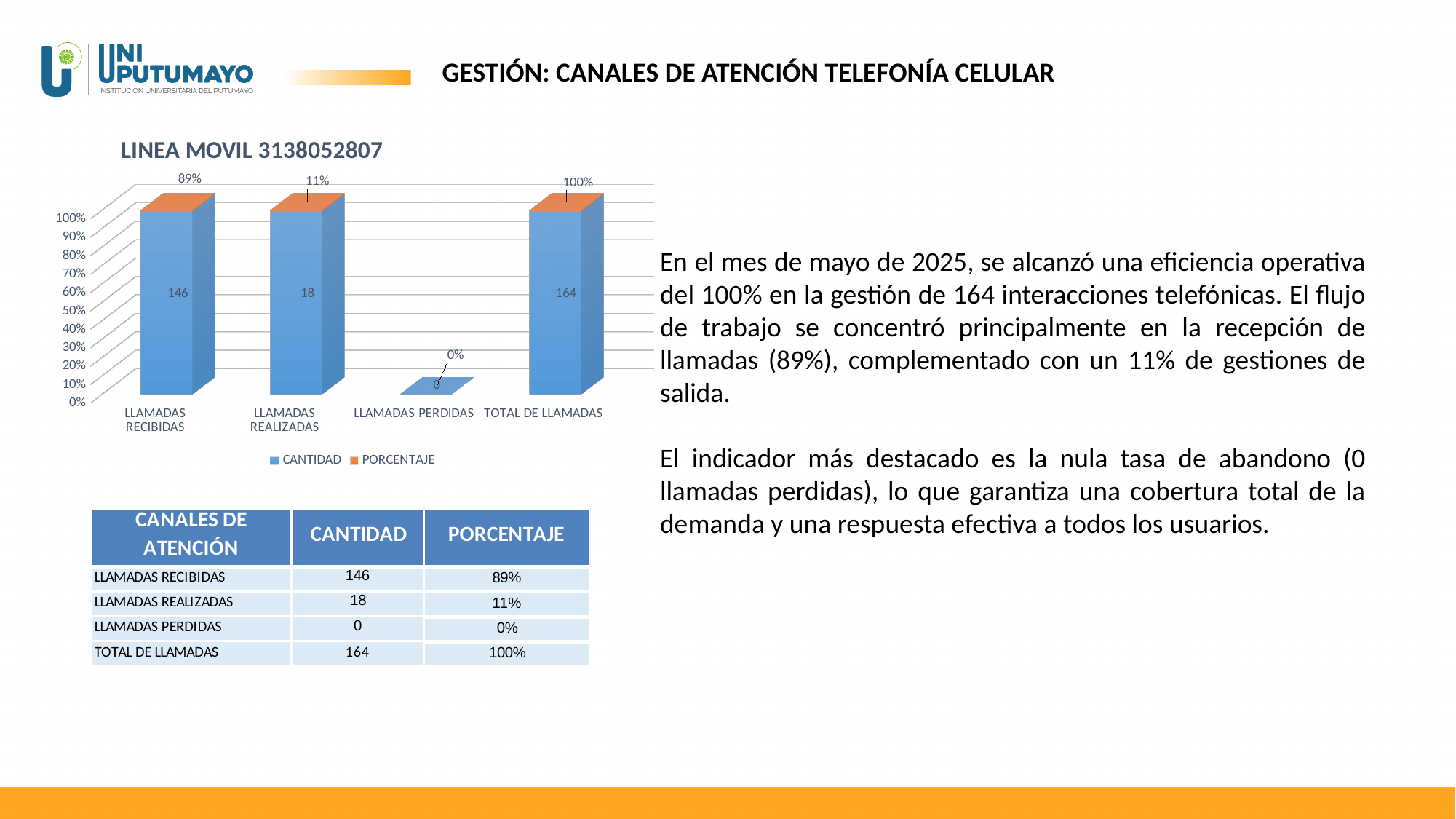
What type of chart is shown on the slide? bar chart What is the PORCENTAJE value for LLAMADAS PERDIDAS? 0% Which category has the highest CANTIDAD value? TOTAL DE LLAMADAS Which is larger, the PORCENTAJE for LLAMADAS RECIBIDAS or for LLAMADAS REALIZADAS? LLAMADAS RECIBIDAS What is the CANTIDAD value for LLAMADAS REALIZADAS? 18 What is the PORCENTAJE value for LLAMADAS RECIBIDAS? 89% Which category has the lowest CANTIDAD value? LLAMADAS PERDIDAS What is the title of the chart? LINEA MOVIL 3138052807 What is the CANTIDAD value for LLAMADAS RECIBIDAS? 146 What is the difference between the CANTIDAD values for LLAMADAS RECIBIDAS and LLAMADAS REALIZADAS? 128 How many series does the chart legend list? 2 How many categories are shown on the x axis of the chart? 4